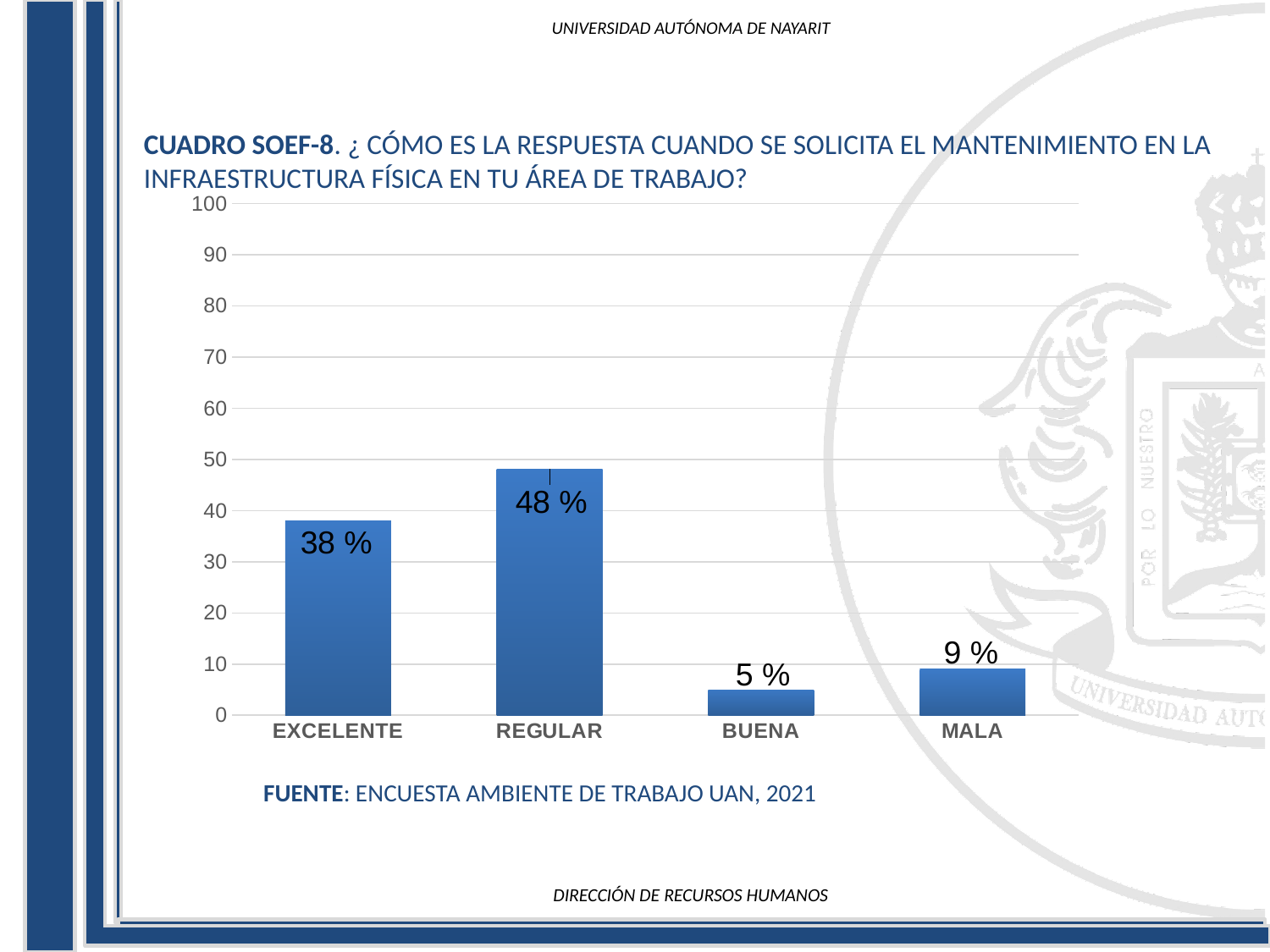
What is the source cited below the chart? ENCUESTA AMBIENTE DE TRABAJO UAN, 2021 What is the difference between the values for REGULAR and EXCELENTE? 10 % Which is larger, the value for MALA or the value for BUENA? MALA What is the value for EXCELENTE? 38 % Which category has the lowest value? BUENA What is the value for REGULAR? 48 % What kind of chart is shown on the slide? bar chart What is the value for MALA? 9 % How many categories are shown on the x axis? 4 What is the value for BUENA? 5 % Which category has the highest value? REGULAR Is the value for EXCELENTE greater or less than 30? greater